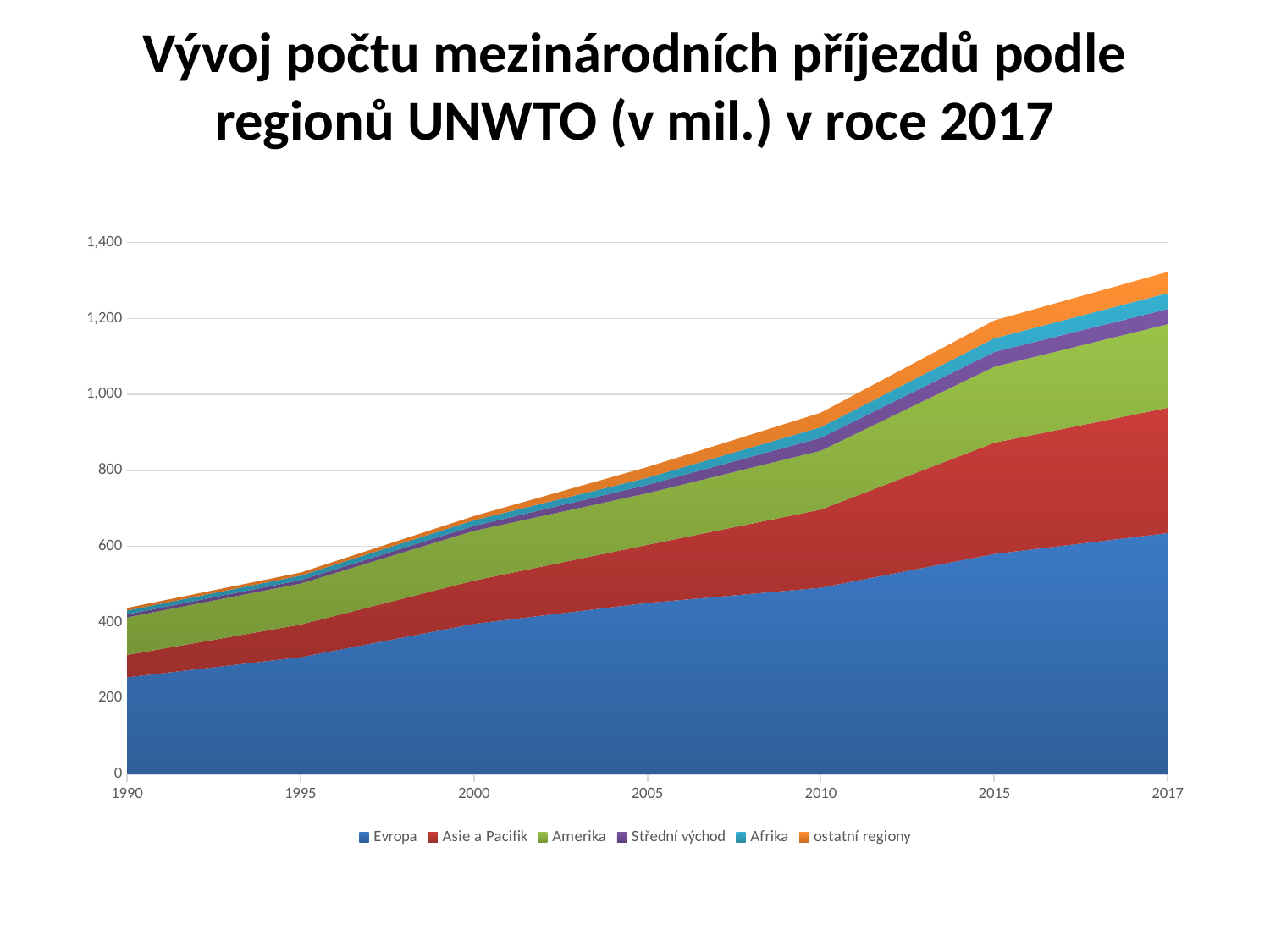
Does the total number of international arrivals rise or fall from 1990 to 2017? rise Is the value for Evropa in 2017 greater or less than 600? greater Is the stacked total for 2010 greater or less than 1,000? less What is the first series listed in the legend? Evropa What is the title of the chart? Vývoj počtu mezinárodních příjezdů podle regionů UNWTO (v mil.) v roce 2017 Is the stacked total for 2017 greater or less than 1,200? greater In 2017, which is larger: the value for Evropa or the value for Asie a Pacifik? Evropa What kind of chart is shown on the slide? stacked area chart Which region has the largest band in the chart? Evropa How many years are marked on the x axis? 7 How many series does the legend list? 6